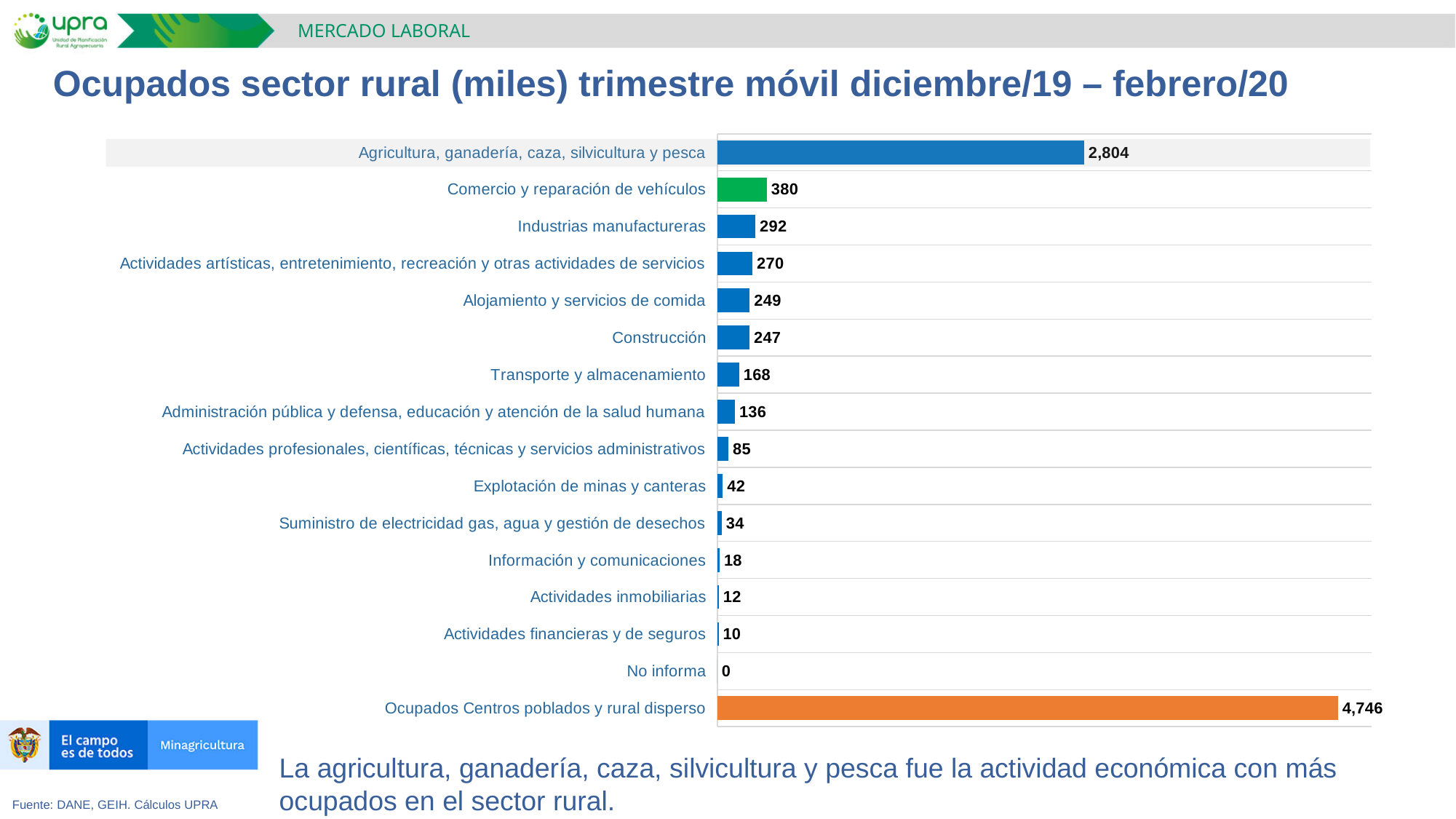
What is the value for Transporte y almacenamiento? 168 What is the value for Comercio y reparación de vehículos? 380 What is the value for Agricultura, ganadería, caza, silvicultura y pesca? 2,804 What is the title of the chart? Ocupados sector rural (miles) trimestre móvil diciembre/19 – febrero/20 Which is larger: the value for Transporte y almacenamiento or the value for Administración pública y defensa, educación y atención de la salud humana? Transporte y almacenamiento What is the difference between the values for Comercio y reparación de vehículos and Industrias manufactureras? 88 What is the value for Ocupados Centros poblados y rural disperso? 4,746 Which category has the longest bar in the chart? Ocupados Centros poblados y rural disperso Which category has the lowest value in the chart? No informa What type of chart is shown on the slide? Bar chart How many categories are shown in the chart? 16 What is the difference between the values for Agricultura, ganadería, caza, silvicultura y pesca and Comercio y reparación de vehículos? 2,424